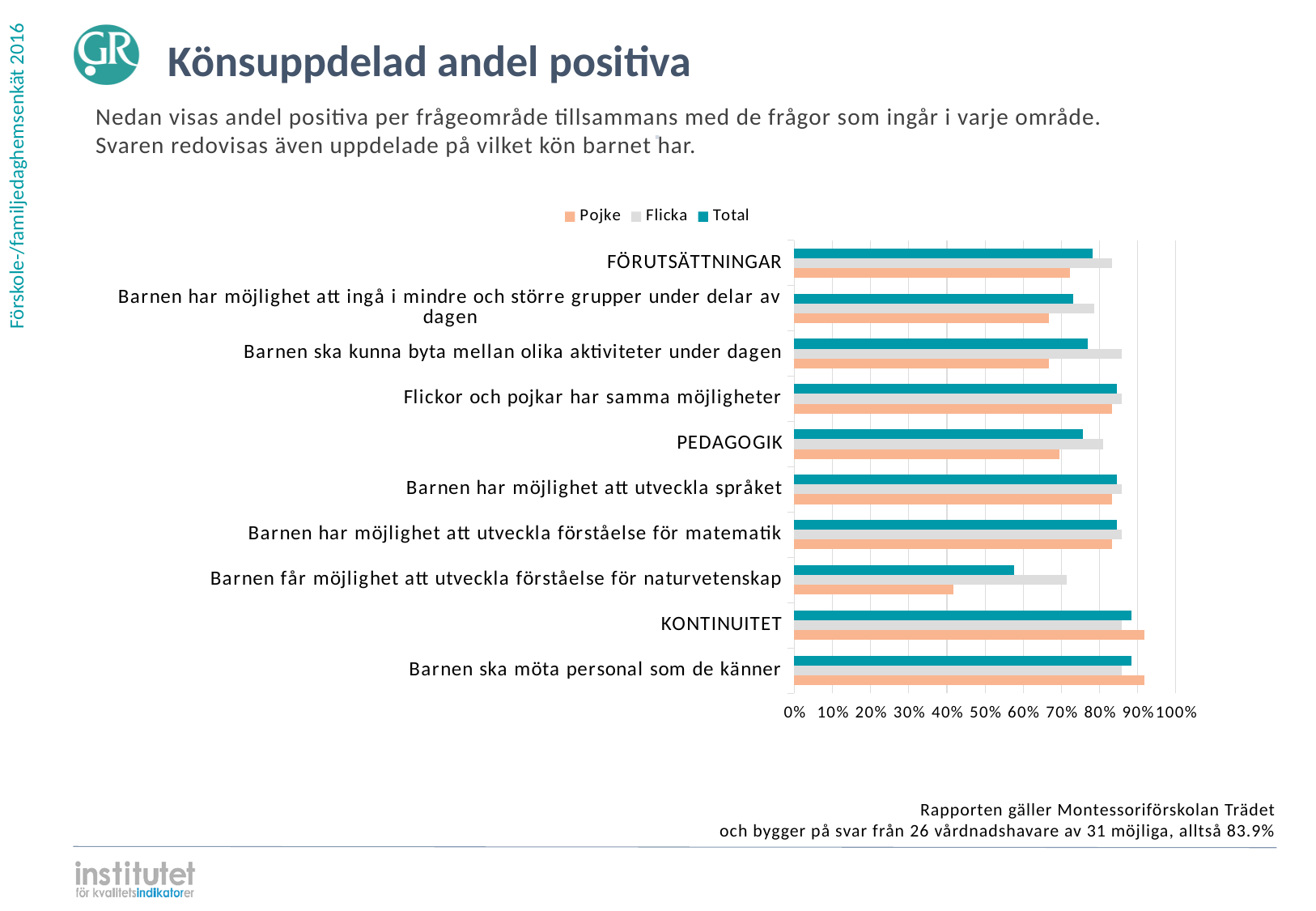
How many series does the legend list? 3 Which category has the lowest Pojke value? Barnen får möjlighet att utveckla förståelse för naturvetenskap What are the three series named in the legend? Pojke, Flicka, Total Is the Flicka value for 'Barnen får möjlighet att utveckla förståelse för naturvetenskap' greater or less than 60%? greater Is the Total value for KONTINUITET greater or less than 80%? greater For FÖRUTSÄTTNINGAR, which is larger: the Pojke value or the Flicka value? Flicka Which category has the lowest Total value? Barnen får möjlighet att utveckla förståelse för naturvetenskap How many categories are plotted on the y axis of the chart? 10 For 'Barnen får möjlighet att utveckla förståelse för naturvetenskap', which is larger: the Pojke value or the Flicka value? Flicka What kind of chart is shown on the slide? Bar chart Is the Pojke value for 'Barnen får möjlighet att utveckla förståelse för naturvetenskap' greater or less than 50%? less What is the title of the slide containing the chart? Könsuppdelad andel positiva